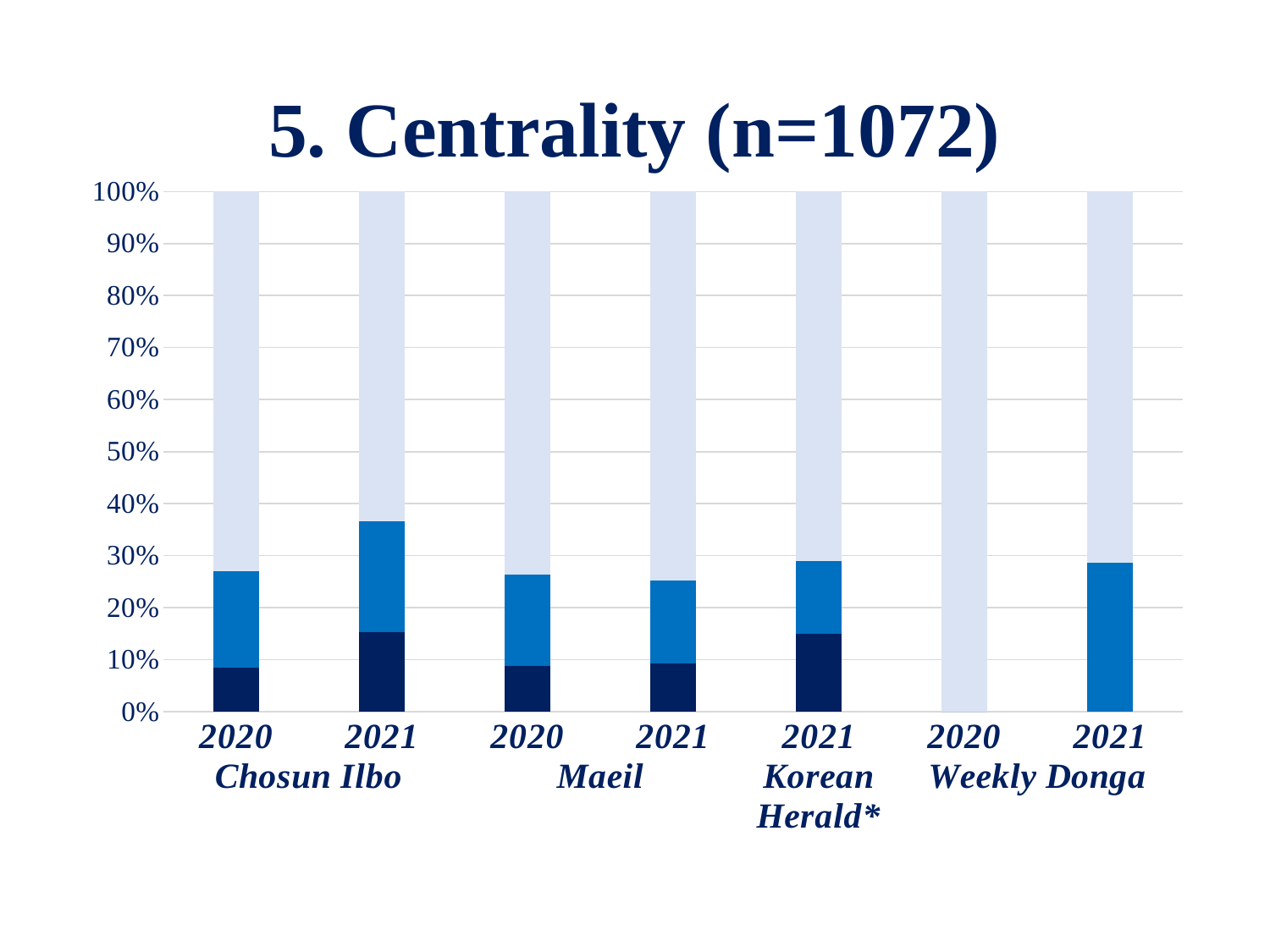
Which has the larger dark-blue segment, 2020 Chosun Ilbo or 2021 Chosun Ilbo? 2021 Chosun Ilbo How many bars are plotted in the chart? 7 What is the title of the chart? 5. Centrality (n=1072) What kind of chart is shown on the slide? Stacked bar chart Is the top of the medium-blue segment for 2021 Chosun Ilbo greater or less than 30%? greater Which has the larger combined dark-blue and medium-blue portion, 2021 Maeil or 2021 Chosun Ilbo? 2021 Chosun Ilbo Is the top of the medium-blue segment for 2020 Chosun Ilbo greater or less than 20%? greater Is the dark-blue segment for 2021 Chosun Ilbo greater or less than 10%? greater How many newspapers are named along the x axis? 4 Which bar consists entirely of the light-blue segment? 2020 Weekly Donga Which bar has the tallest combined dark-blue and medium-blue portion? 2021 Chosun Ilbo